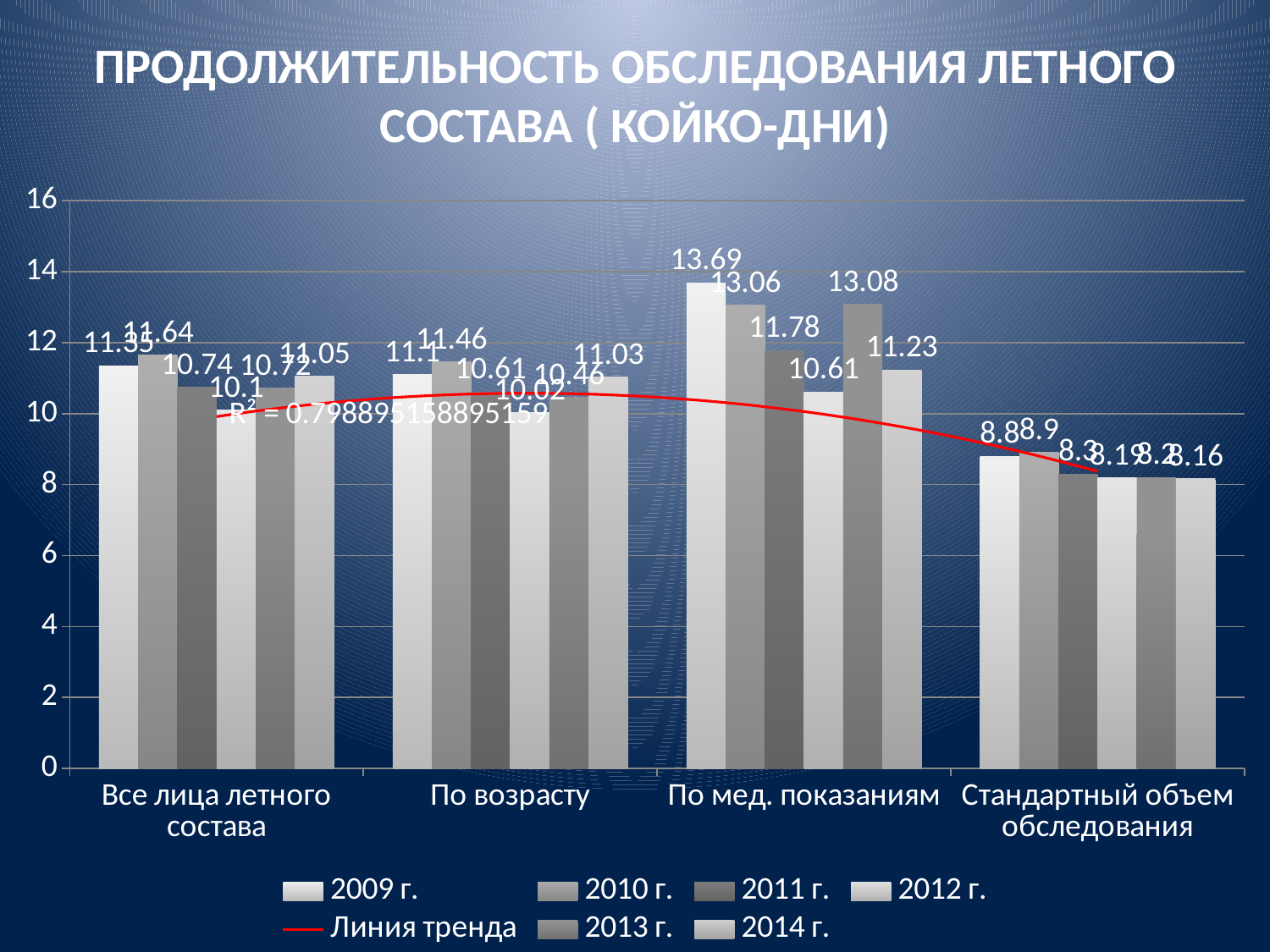
What R² value is printed on the chart for the trend line? 0.798895158895159 What is the value for 2013 г. in the По мед. показаниям category? 13.08 How many entries does the legend list? 7 What is the difference between the 2009 г. and 2014 г. values in the По мед. показаниям category? 2.46 In the По мед. показаниям category, which is larger: the 2009 г. value or the 2010 г. value? 2009 г. What is the value for 2010 г. in the Все лица летного состава category? 11.64 How many categories are shown on the x axis? 4 What kind of chart is shown on the slide? bar chart What is the value for 2009 г. in the По мед. показаниям category? 13.69 Which category and year has the highest value on the chart? По мед. показаниям, 2009 г. (13.69) What is the value for 2012 г. in the По возрасту category? 10.02 Is the 2009 г. value for Стандартный объем обследования greater or less than 10? less